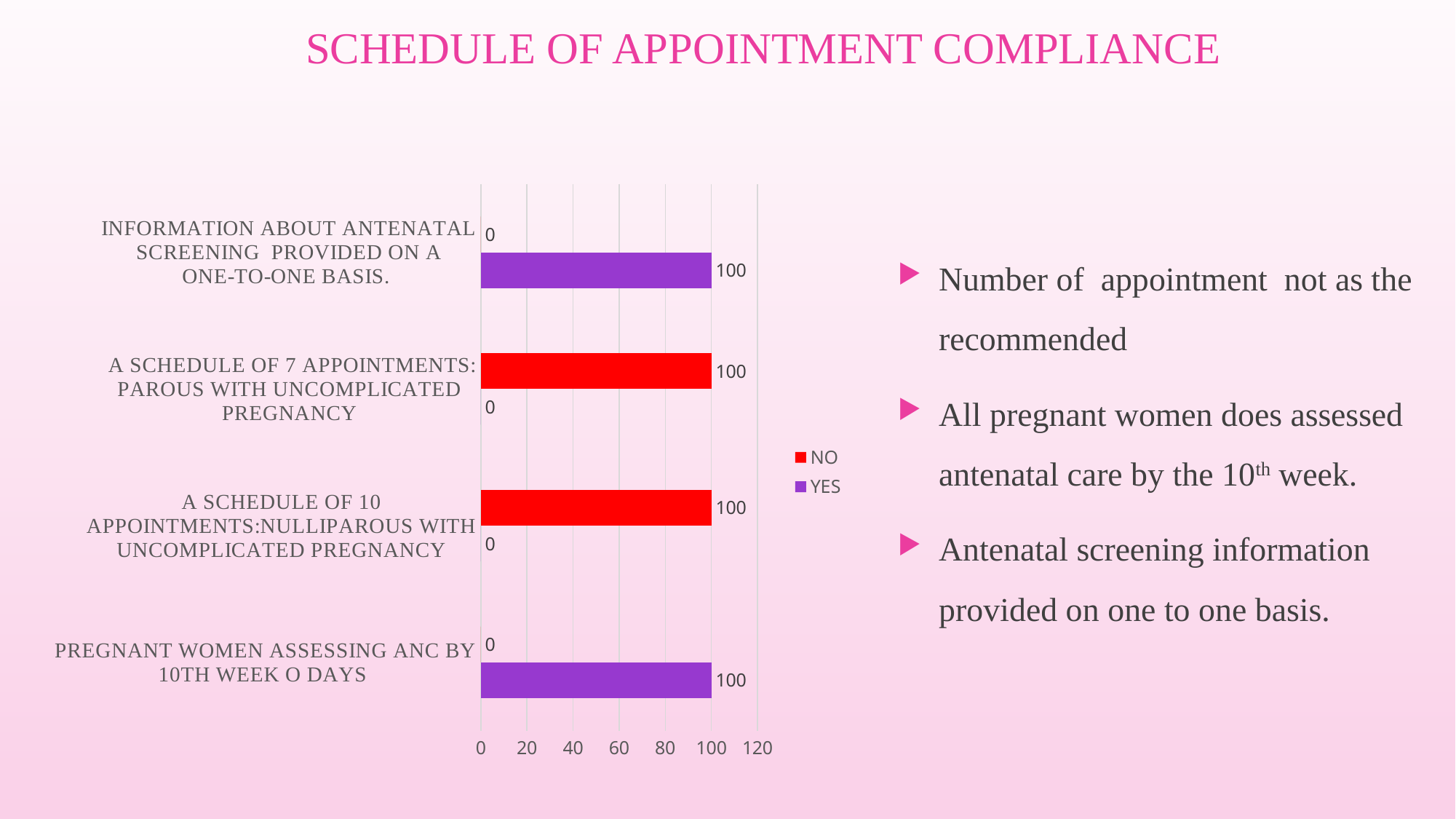
Which is larger for 'A schedule of 10 appointments: nulliparous with uncomplicated pregnancy', the NO value or the YES value? NO Is the NO value for 'A schedule of 7 appointments: parous with uncomplicated pregnancy' greater or less than 80? greater What is the difference between the YES and NO values for 'Pregnant women assessing ANC by 10th week 0 days'? 100 How many categories are shown on the chart? 4 What is the title of the slide containing the chart? SCHEDULE OF APPOINTMENT COMPLIANCE What kind of chart is shown on the slide? Bar chart What colour represents the NO series in the chart? Red How many series does the chart legend list? 2 What is the YES value for 'Information about antenatal screening provided on a one-to-one basis'? 100 What is the NO value for 'A schedule of 7 appointments: parous with uncomplicated pregnancy'? 100 What is the NO value for 'Pregnant women assessing ANC by 10th week 0 days'? 0 What is the YES value for 'A schedule of 10 appointments: nulliparous with uncomplicated pregnancy'? 0